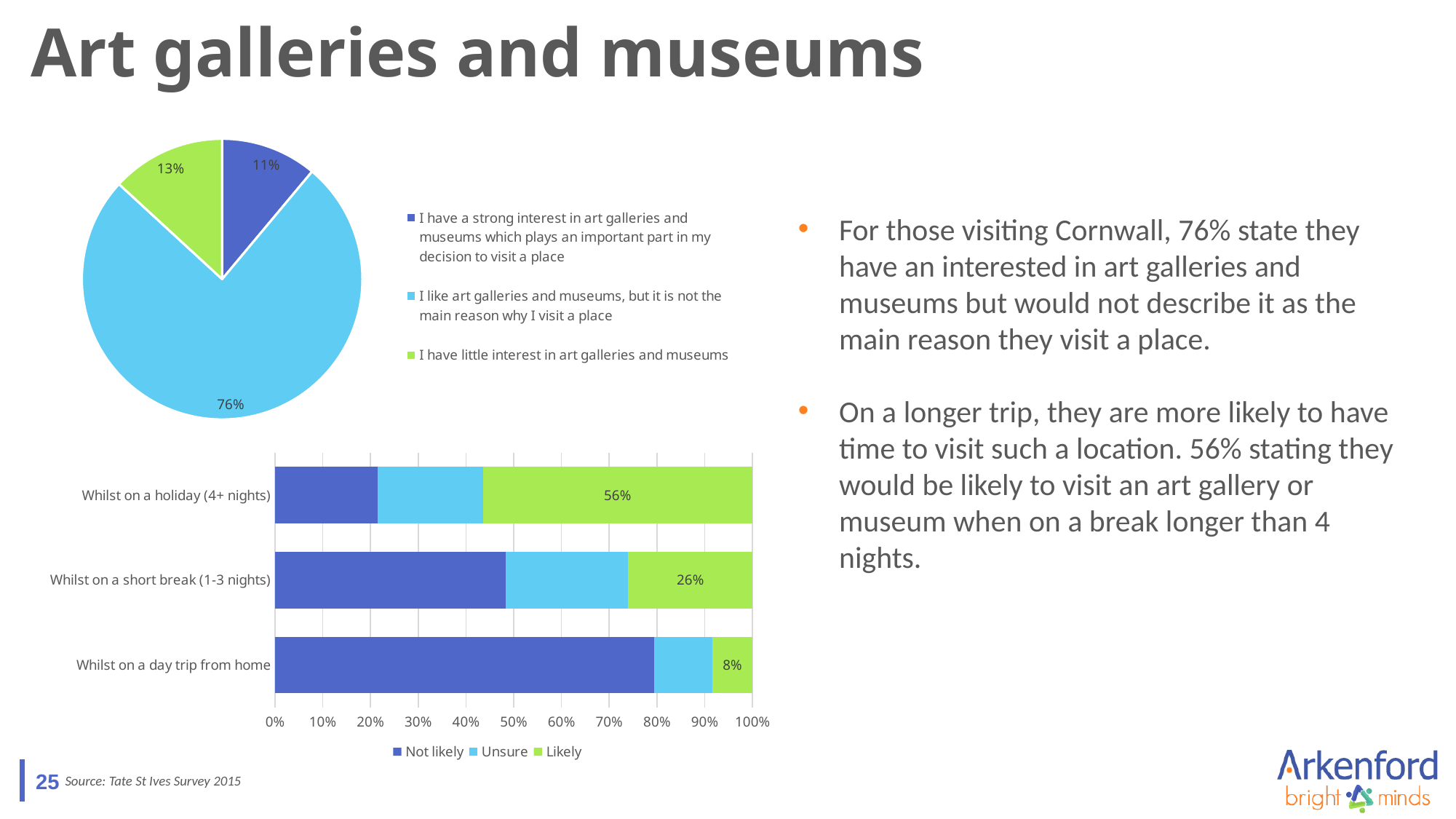
In the bottom bar chart, what is the difference in the 'Likely' percentage between a holiday (4+ nights) and a short break (1-3 nights)? 30 percentage points In the pie chart, what percentage of respondents said they like art galleries and museums but it is not the main reason they visit a place? 76% What type of chart is the bottom chart on the slide? Stacked bar chart In the bottom bar chart, what percentage are likely to visit an art gallery or museum whilst on a holiday (4+ nights)? 56% In the bottom bar chart, is the 'Not likely' value for a day trip from home greater or less than 70%? greater How many slices does the pie chart have? 3 How many series does the legend of the bottom bar chart list? 3 In the pie chart, which response has the smallest share? I have a strong interest in art galleries and museums which plays an important part in my decision to visit a place In the pie chart, how many percentage points larger is the 'I like art galleries and museums, but it is not the main reason' slice than the 'strong interest' slice? 65 percentage points In the pie chart, what percentage said they have little interest in art galleries and museums? 13% In the bottom bar chart, is the 'Not likely' value for a holiday (4+ nights) greater or less than 30%? less In the bottom bar chart, what percentage are likely to visit whilst on a day trip from home? 8%